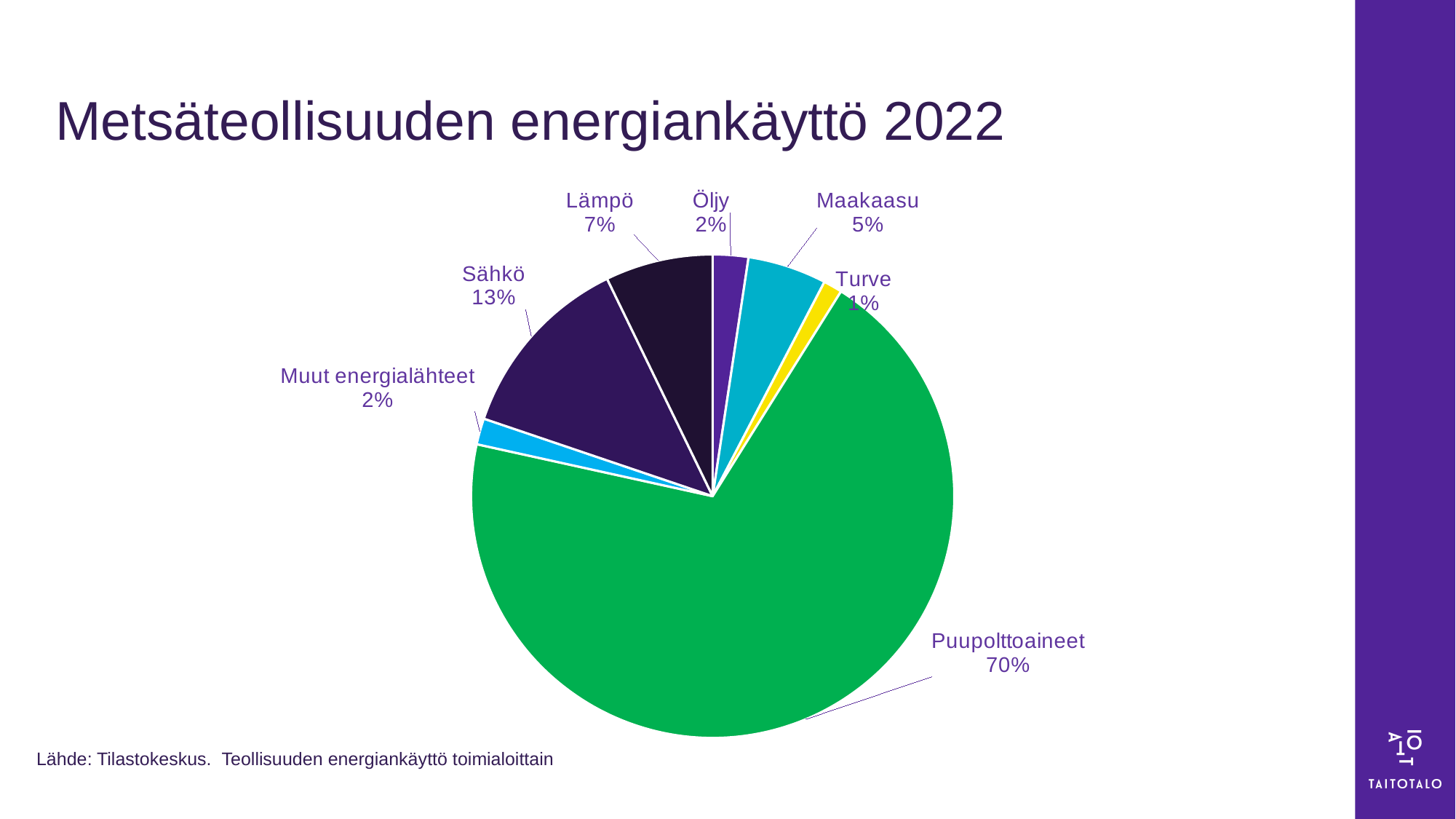
What is the value shown for Turve? 1% What kind of chart is shown on the slide? Pie chart What is the value shown for Lämpö? 7% What is the value shown for Sähkö? 13% How many categories are shown in the pie chart? 7 What is the title of the slide? Metsäteollisuuden energiankäyttö 2022 Which is larger, Maakaasu or Öljy? Maakaasu What is the value shown for Maakaasu? 5% Which category has the largest slice of the pie? Puupolttoaineet What is the difference in percentage points between Sähkö and Lämpö? 6 Which category has the smallest slice of the pie? Turve What share of the pie does Puupolttoaineet have? 70%